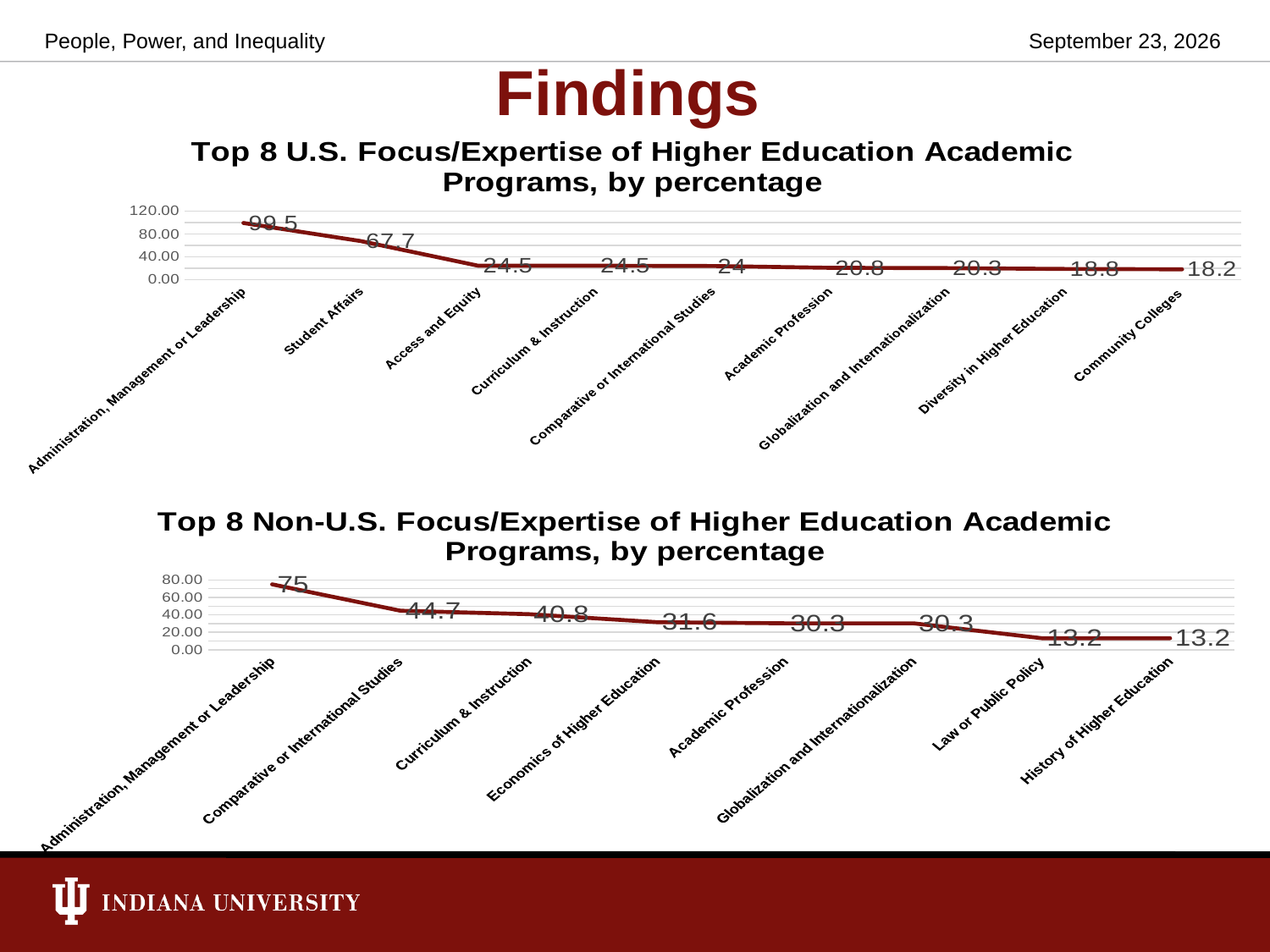
In the top chart (Top 8 U.S. Focus/Expertise), how many categories are plotted along the x axis? 9 In the top chart (Top 8 U.S. Focus/Expertise), what is the value for Community Colleges? 18.2 In the top chart (Top 8 U.S. Focus/Expertise), what is the value for Student Affairs? 67.7 In the top chart (Top 8 U.S. Focus/Expertise), which category has the highest value? Administration, Management or Leadership What type of chart is the bottom chart (Top 8 Non-U.S. Focus/Expertise)? line chart In the bottom chart (Top 8 Non-U.S. Focus/Expertise), what is the value for Administration, Management or Leadership? 75 In the bottom chart (Top 8 Non-U.S. Focus/Expertise), what is the value for Economics of Higher Education? 31.6 In the top chart (Top 8 U.S. Focus/Expertise), do the values rise or fall from left to right? fall In the bottom chart (Top 8 Non-U.S. Focus/Expertise), which is larger, Comparative or International Studies or Curriculum & Instruction? Comparative or International Studies In the top chart (Top 8 U.S. Focus/Expertise), what is the difference between Administration, Management or Leadership and Student Affairs? 31.8 In the bottom chart (Top 8 Non-U.S. Focus/Expertise), what is the difference between Comparative or International Studies and Law or Public Policy? 31.5 In the bottom chart (Top 8 Non-U.S. Focus/Expertise), how many categories are plotted? 8